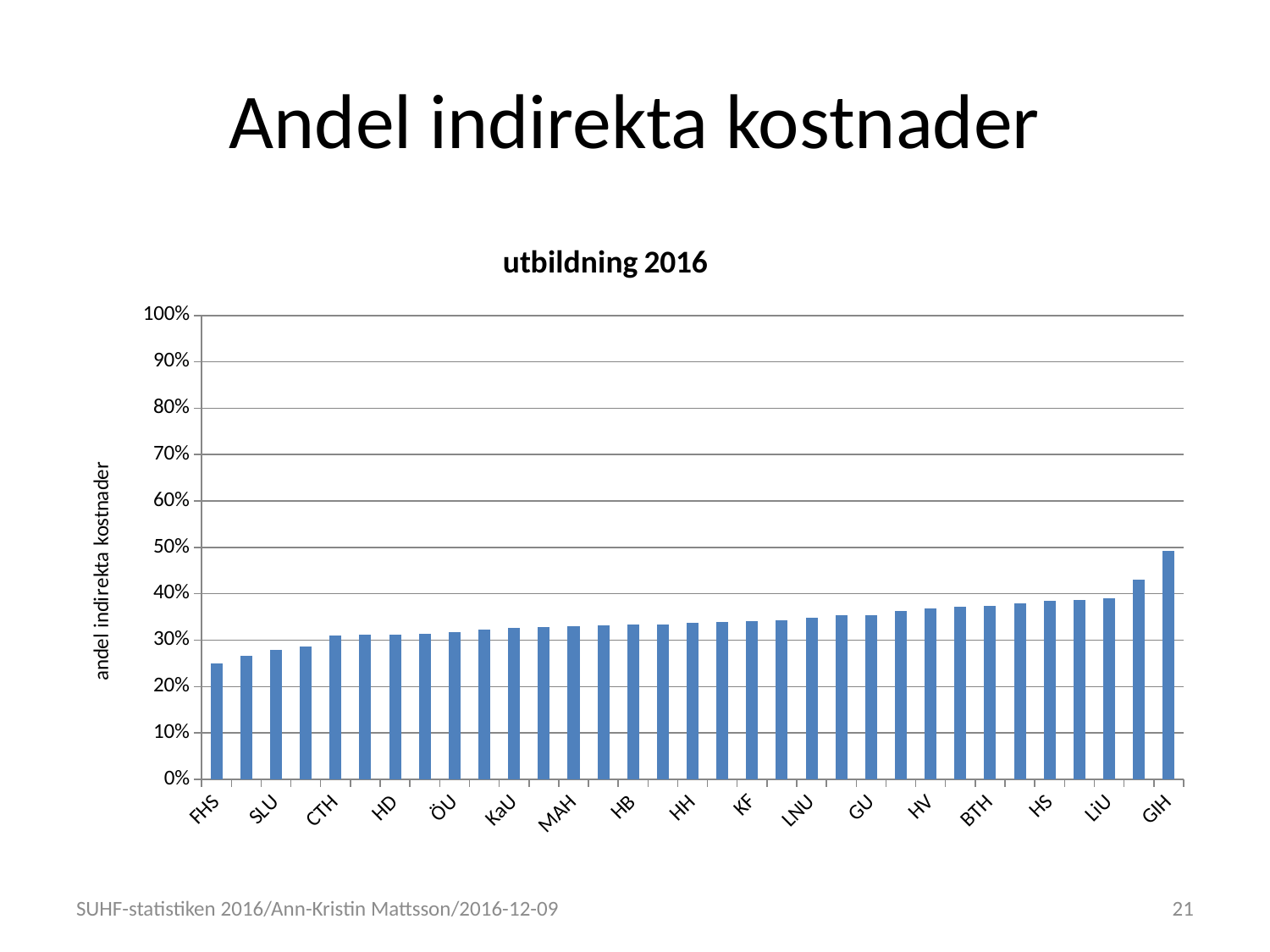
Is the value for GIH greater or less than 40%? greater Is the value for SLU greater or less than 30%? less Which has the larger value, HS or SLU? HS Is the value for HV greater or less than 30%? greater Which category has the highest value in the chart? GIH What is the title of the chart? utbildning 2016 Which has the larger value, LiU or HD? LiU What kind of chart is shown on the slide? bar chart Which category has the lowest value in the chart? FHS Do the values generally rise or fall from left to right along the x axis? rise